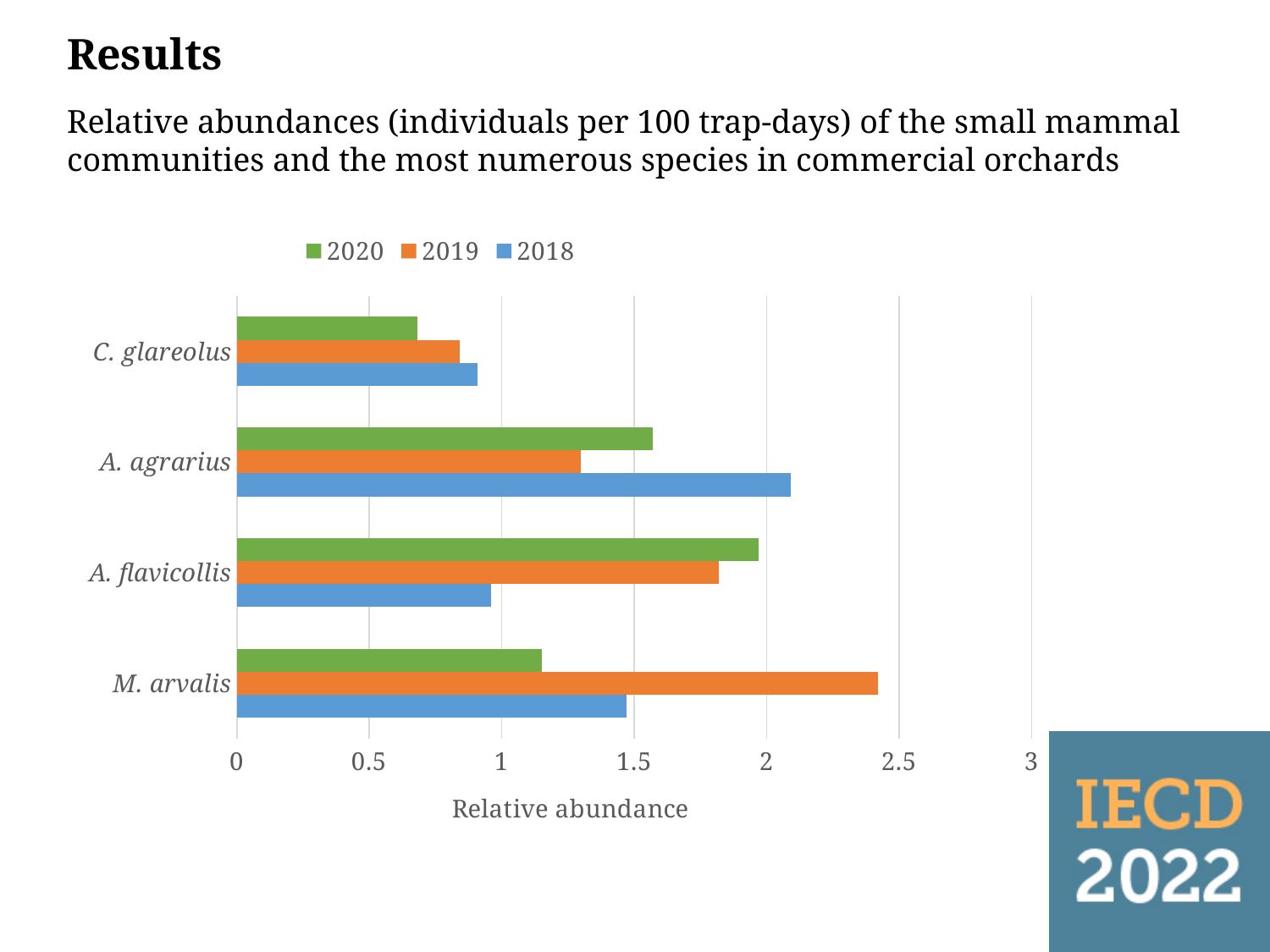
For A. flavicollis, which year has the larger relative abundance, 2020 or 2018? 2020 Is the 2018 value for A. agrarius greater or less than 1.5? greater How many series does the legend list? 3 Which species has the highest relative abundance in 2019? M. arvalis Is the 2020 value for C. glareolus greater or less than 1? less How many species categories are plotted on the chart? 4 Which species has the lowest relative abundance in 2020? C. glareolus For C. glareolus, which year has the larger relative abundance, 2018 or 2020? 2018 What kind of chart is shown on the slide? bar chart What is the title of the horizontal axis? Relative abundance Is the 2019 value for M. arvalis greater or less than 2? greater Which species has the highest relative abundance in 2018? A. agrarius